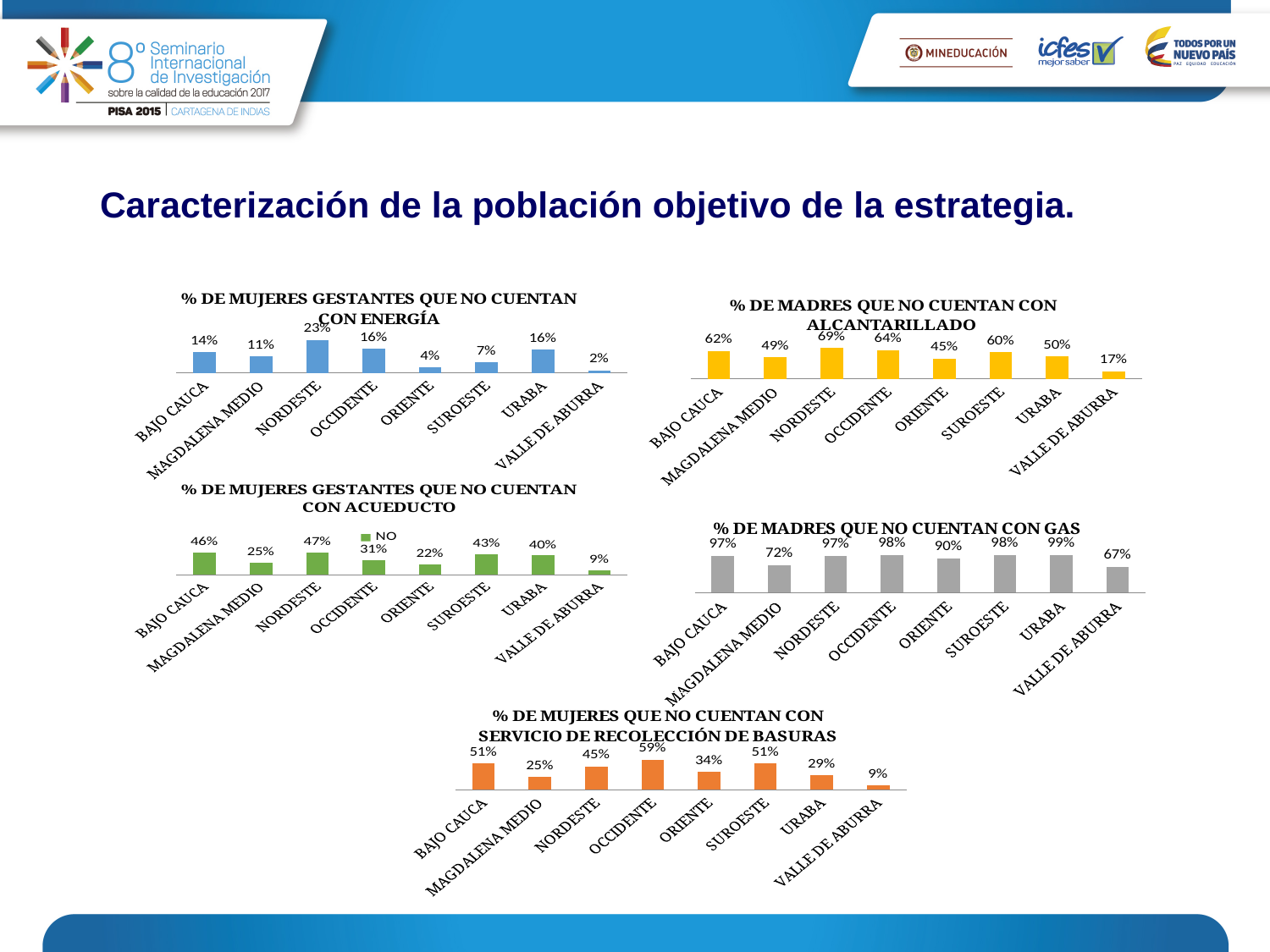
In the chart '% DE MUJERES GESTANTES QUE NO CUENTAN CON ACUEDUCTO', which is larger, BAJO CAUCA or OCCIDENTE? BAJO CAUCA In the chart '% DE MADRES QUE NO CUENTAN CON GAS', what is the value for URABA? 99% In the chart '% DE MADRES QUE NO CUENTAN CON ALCANTARILLADO', what is the value for ORIENTE? 45% In the chart '% DE MADRES QUE NO CUENTAN CON ALCANTARILLADO', what is the difference between BAJO CAUCA and VALLE DE ABURRA? 45% In the chart '% DE MUJERES GESTANTES QUE NO CUENTAN CON ENERGÍA', which region has the lowest value? VALLE DE ABURRA What type of chart is '% DE MADRES QUE NO CUENTAN CON GAS'? Bar chart In the chart '% DE MUJERES QUE NO CUENTAN CON SERVICIO DE RECOLECCIÓN DE BASURAS', which region has the highest value? OCCIDENTE In the chart '% DE MADRES QUE NO CUENTAN CON GAS', which region has the lowest value? VALLE DE ABURRA In the chart '% DE MUJERES GESTANTES QUE NO CUENTAN CON ENERGÍA', what is the value for NORDESTE? 23% In the chart '% DE MADRES QUE NO CUENTAN CON ALCANTARILLADO', which region has the highest value? NORDESTE How many regions are shown in the chart '% DE MUJERES QUE NO CUENTAN CON SERVICIO DE RECOLECCIÓN DE BASURAS'? 8 In the chart '% DE MUJERES GESTANTES QUE NO CUENTAN CON ACUEDUCTO', what is the value for SUROESTE? 43%